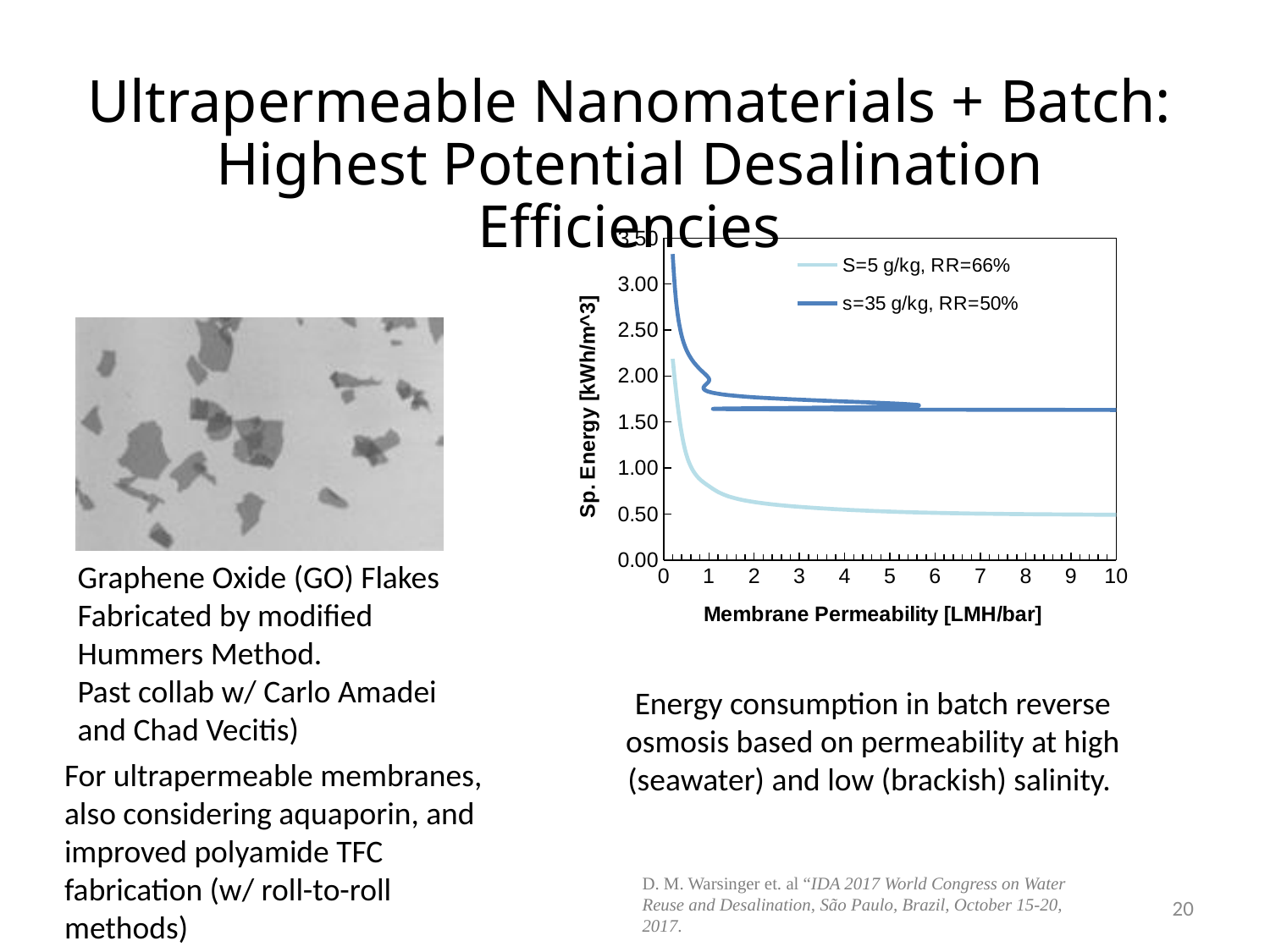
What is the title of the chart's x axis? Membrane Permeability [LMH/bar] Which series has the lower specific energy at a membrane permeability of 8 LMH/bar? S=5 g/kg, RR=66% Is the specific energy for the s=35 g/kg, RR=50% series at a permeability of 2 LMH/bar greater or less than 1.50? greater What kind of chart is shown on the slide? line chart Is the specific energy for the S=5 g/kg, RR=66% series at a permeability of 10 LMH/bar greater or less than 1.00? less Which series has the higher specific energy at a membrane permeability of 5 LMH/bar? s=35 g/kg, RR=50% Does the specific energy rise or fall as membrane permeability increases along the x axis? fall Is the specific energy for the s=35 g/kg, RR=50% series at a permeability of 10 LMH/bar greater or less than 1.50? greater How many series does the chart legend list? 2 What is the title of the chart's y axis? Sp. Energy [kWh/m^3]